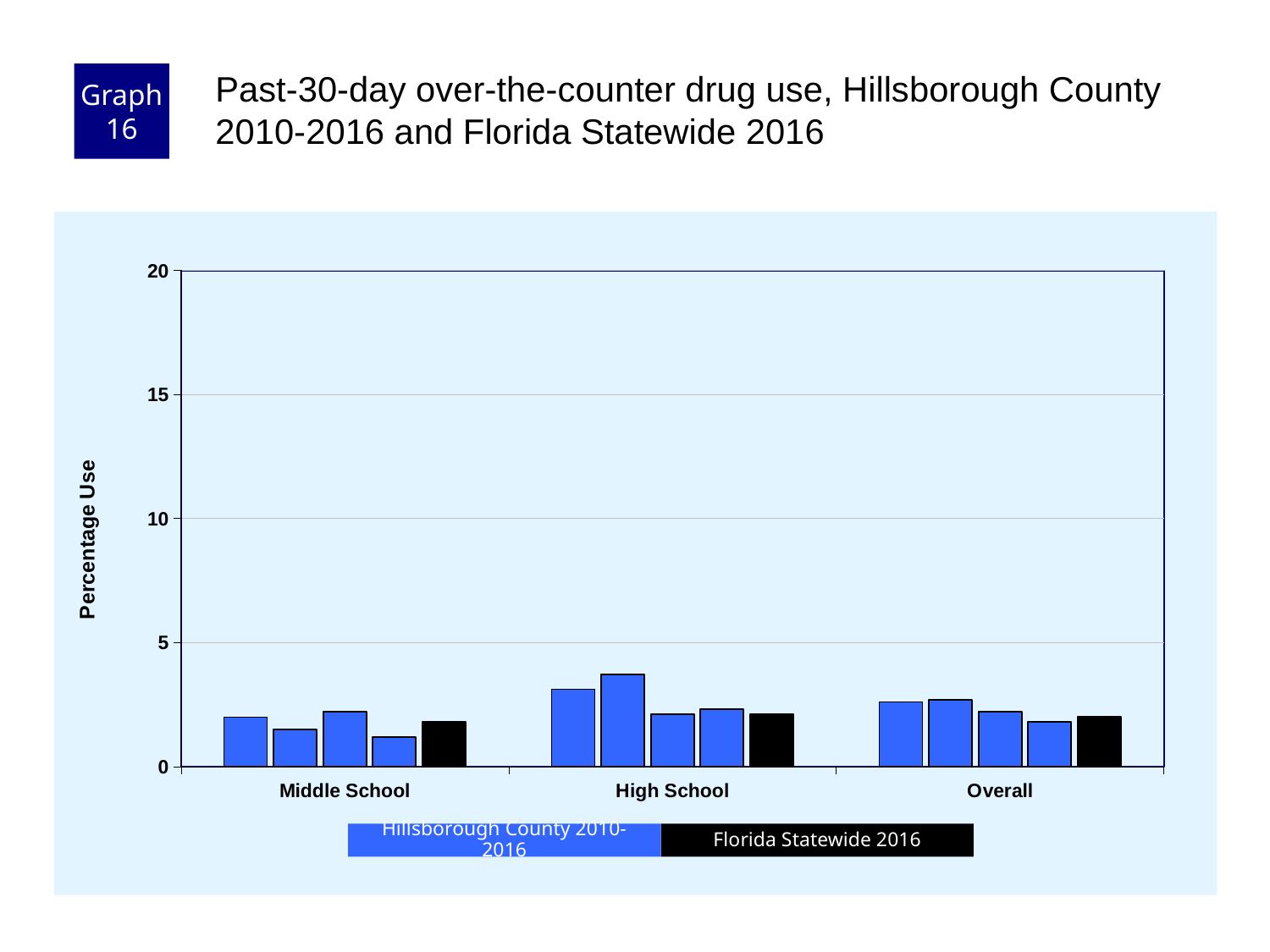
Is the Florida Statewide 2016 value for Middle School greater or less than 5? less Is the tallest bar on the chart greater or less than 10? less How many series does the legend list? 2 Which category has a taller tallest bar, Middle School or High School? High School Is the Florida Statewide 2016 value for High School greater or less than 5? less How many categories are shown along the x axis? 3 What kind of chart is shown on the slide? Bar chart What colour are the Florida Statewide 2016 bars? Black What is the label on the y axis? Percentage Use Which category contains the tallest bar on the chart? High School